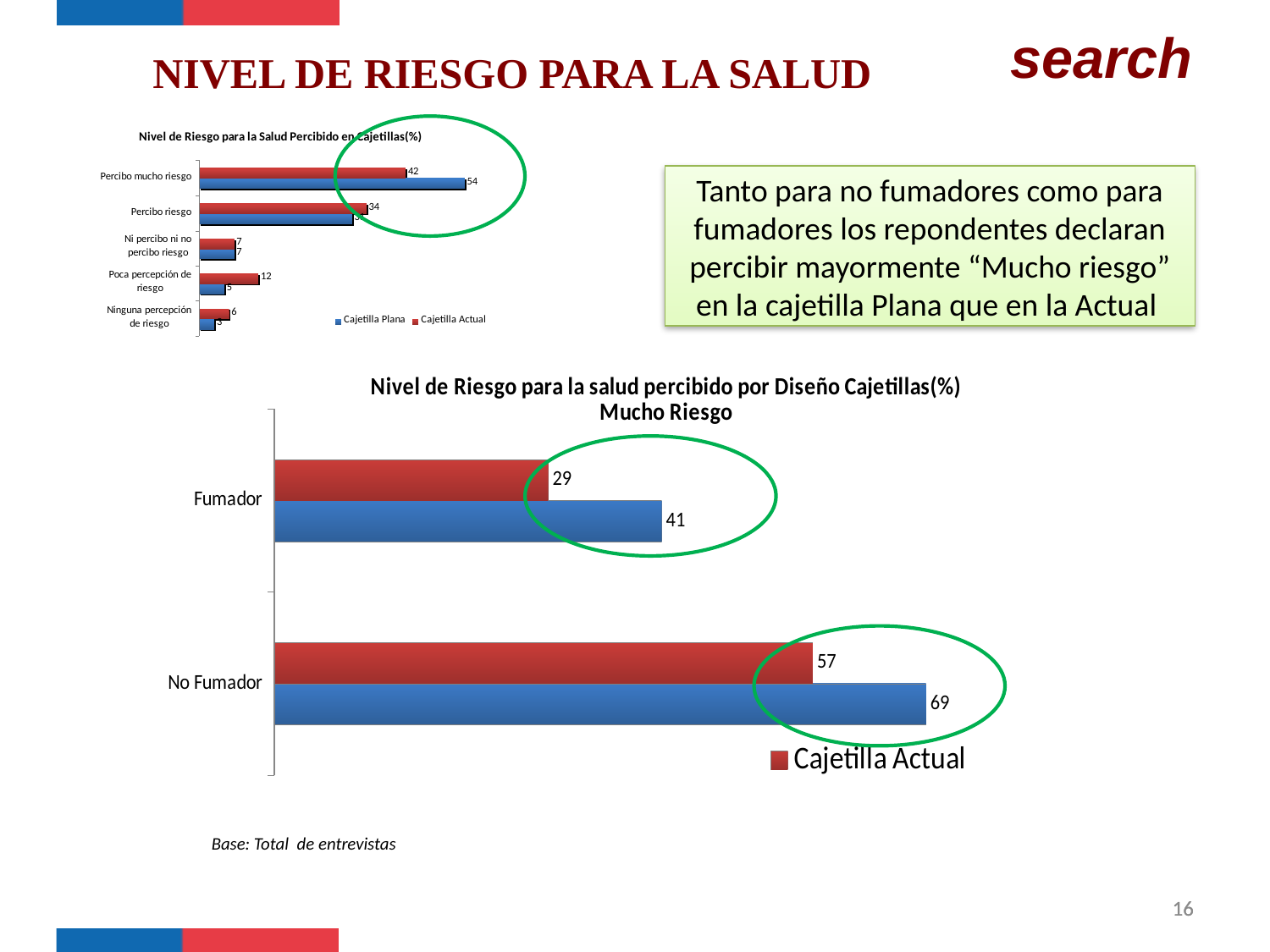
In the bottom chart (Mucho Riesgo), how many categories are shown on the vertical axis? 2 In the top-left chart (Nivel de Riesgo para la Salud Percibido en Cajetillas(%)), how many series does the legend list? 2 What type of chart is the bottom chart (Mucho Riesgo)? Bar chart In the bottom chart (Nivel de Riesgo para la salud percibido por Diseño Cajetillas(%) Mucho Riesgo), what is the value of the blue bar for No Fumador? 69 In the bottom chart (Mucho Riesgo), what is the value of the Cajetilla Actual bar for No Fumador? 57 In the top-left chart (Nivel de Riesgo para la Salud Percibido en Cajetillas(%)), how many categories are shown? 5 In the top-left chart (Nivel de Riesgo para la Salud Percibido en Cajetillas(%)), which is larger for Percibo mucho riesgo: Cajetilla Plana or Cajetilla Actual? Cajetilla Plana In the top-left chart (Nivel de Riesgo para la Salud Percibido en Cajetillas(%)), what is the value of Cajetilla Actual for Poca percepción de riesgo? 12 In the bottom chart (Mucho Riesgo), what is the value of the Cajetilla Actual bar for Fumador? 29 In the bottom chart (Mucho Riesgo), what is the difference between the blue bar and the Cajetilla Actual bar for Fumador? 12 In the bottom chart (Mucho Riesgo), which category has the highest value overall? No Fumador In the top-left chart (Nivel de Riesgo para la Salud Percibido en Cajetillas(%)), what is the value of Cajetilla Plana for Percibo mucho riesgo? 54